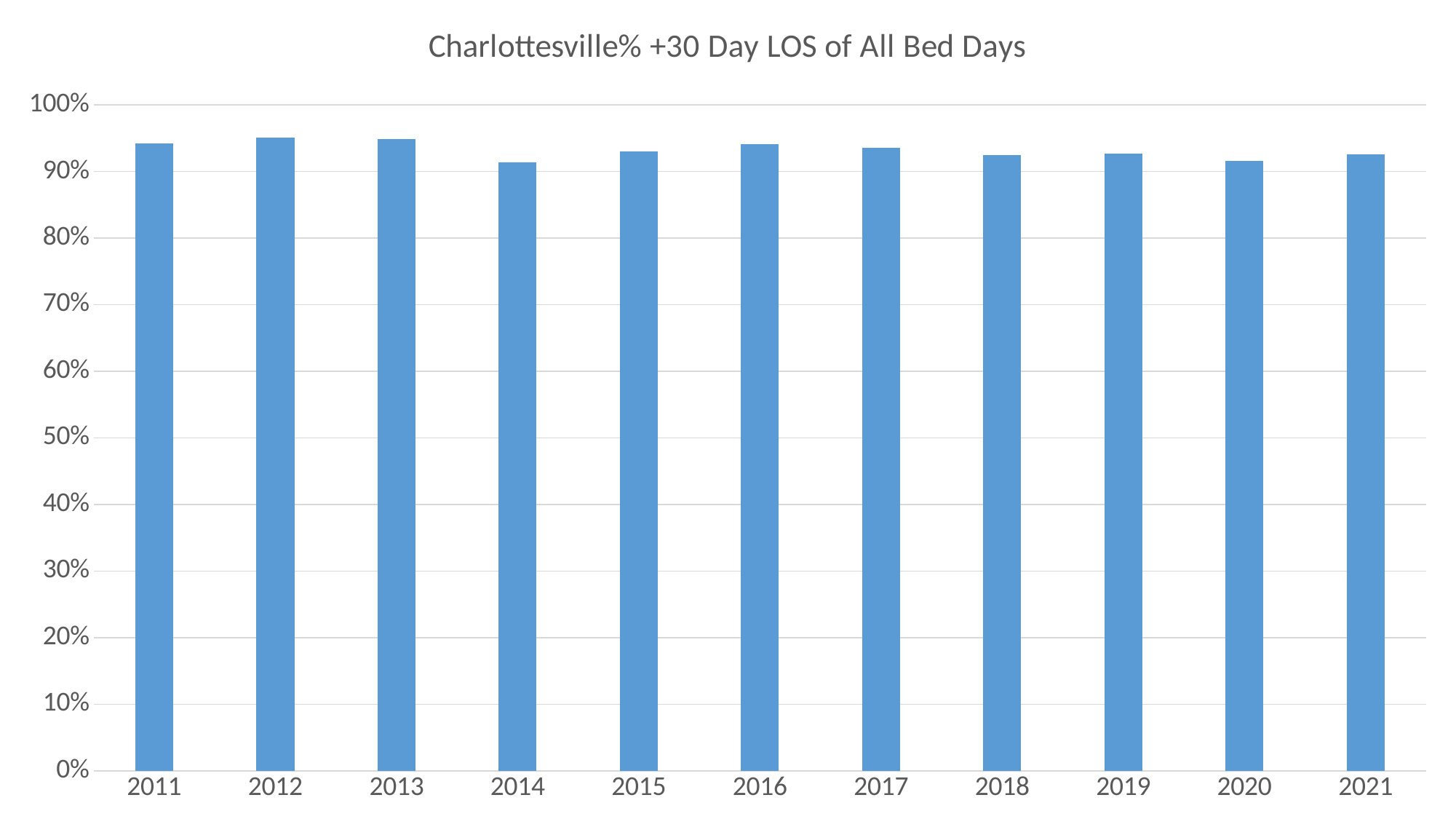
Does the value rise or fall from 2014 to 2015? rise Which is larger, the value for 2011 or the value for 2014? 2011 How many years are shown on the x axis of the chart? 11 Is the value for 2014 greater or less than 100%? less What is the title of the chart? Charlottesville% +30 Day LOS of All Bed Days What is the first year shown on the x axis? 2011 Which is larger, the value for 2012 or the value for 2014? 2012 What kind of chart is shown on the slide? bar chart Is the value for 2021 greater or less than 80%? greater Is the value for 2012 greater or less than 90%? greater Which is larger, the value for 2013 or the value for 2020? 2013 Does the value rise or fall from 2013 to 2014? fall